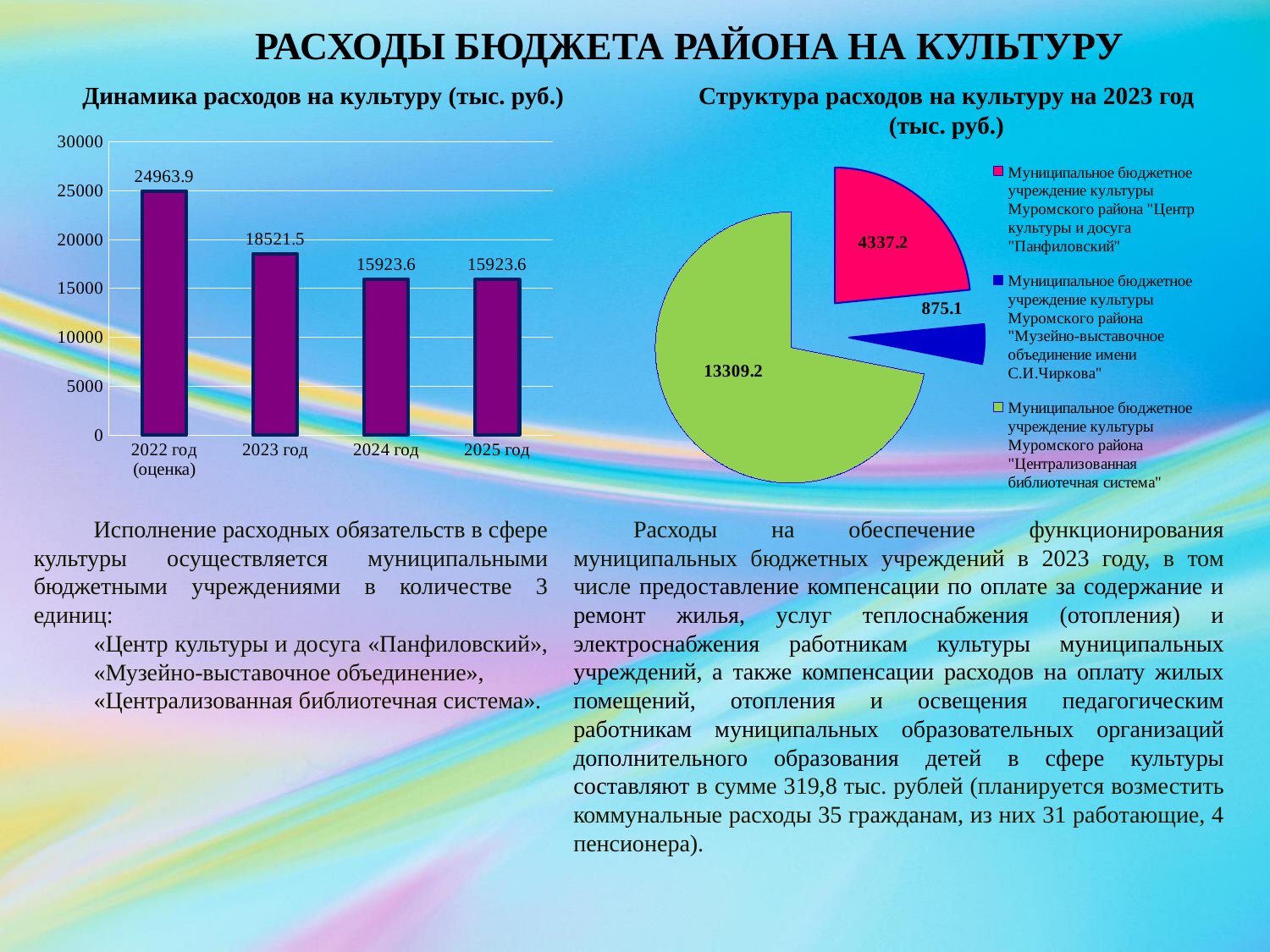
On the bar chart 'Динамика расходов на культуру (тыс. руб.)', what is the value for 2022 год (оценка)? 24963.9 On the pie chart 'Структура расходов на культуру на 2023 год (тыс. руб.)', which institution has the smallest slice? Музейно-выставочное объединение имени С.И.Чиркова What kind of chart is the left chart 'Динамика расходов на культуру (тыс. руб.)'? bar chart On the pie chart 'Структура расходов на культуру на 2023 год (тыс. руб.)', what is the total of all three slices? 18521.5 On the bar chart 'Динамика расходов на культуру (тыс. руб.)', is the value for 2024 год greater or less than 20000? less On the bar chart 'Динамика расходов на культуру (тыс. руб.)', what is the difference between the values for 2022 год (оценка) and 2023 год? 6442.4 On the bar chart 'Динамика расходов на культуру (тыс. руб.)', how many bars are shown? 4 On the pie chart 'Структура расходов на культуру на 2023 год (тыс. руб.)', what is the value for the 'Централизованная библиотечная система' slice? 13309.2 On the pie chart 'Структура расходов на культуру на 2023 год (тыс. руб.)', how many entries does the legend list? 3 On the bar chart 'Динамика расходов на культуру (тыс. руб.)', which year has the highest value? 2022 год (оценка) On the bar chart 'Динамика расходов на культуру (тыс. руб.)', do the values rise or fall from 2022 to 2025? fall On the bar chart 'Динамика расходов на культуру (тыс. руб.)', what is the value for 2023 год? 18521.5